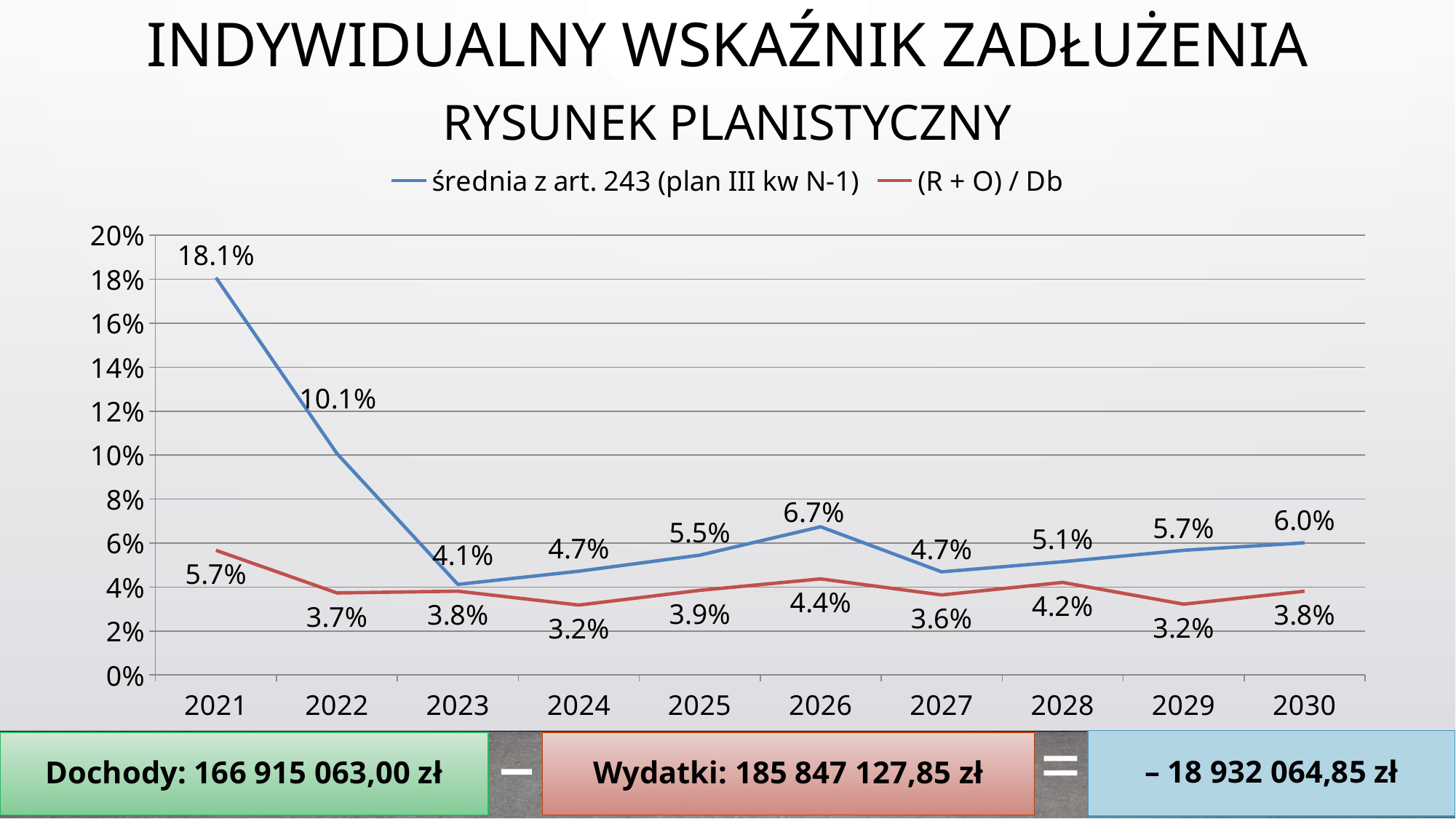
Which series has the larger value in 2026: 'średnia z art. 243 (plan III kw N-1)' or '(R + O) / Db'? średnia z art. 243 (plan III kw N-1) What colour is the line for the '(R + O) / Db' series? Red What is the value of the 'średnia z art. 243 (plan III kw N-1)' series in 2021? 18.1% What is the difference between the 'średnia z art. 243 (plan III kw N-1)' value and the '(R + O) / Db' value in 2021? 12.4% How many years are shown on the x axis of the chart? 10 Does the 'średnia z art. 243 (plan III kw N-1)' series rise or fall between 2021 and 2023? Fall In which year is the 'średnia z art. 243 (plan III kw N-1)' series at its lowest? 2023 In which year is the '(R + O) / Db' series at its highest? 2021 What is the value of the '(R + O) / Db' series in 2026? 4.4% What is the value of the 'średnia z art. 243 (plan III kw N-1)' series in 2030? 6.0% What type of chart is shown on the slide? Line chart How many series does the chart legend list? 2